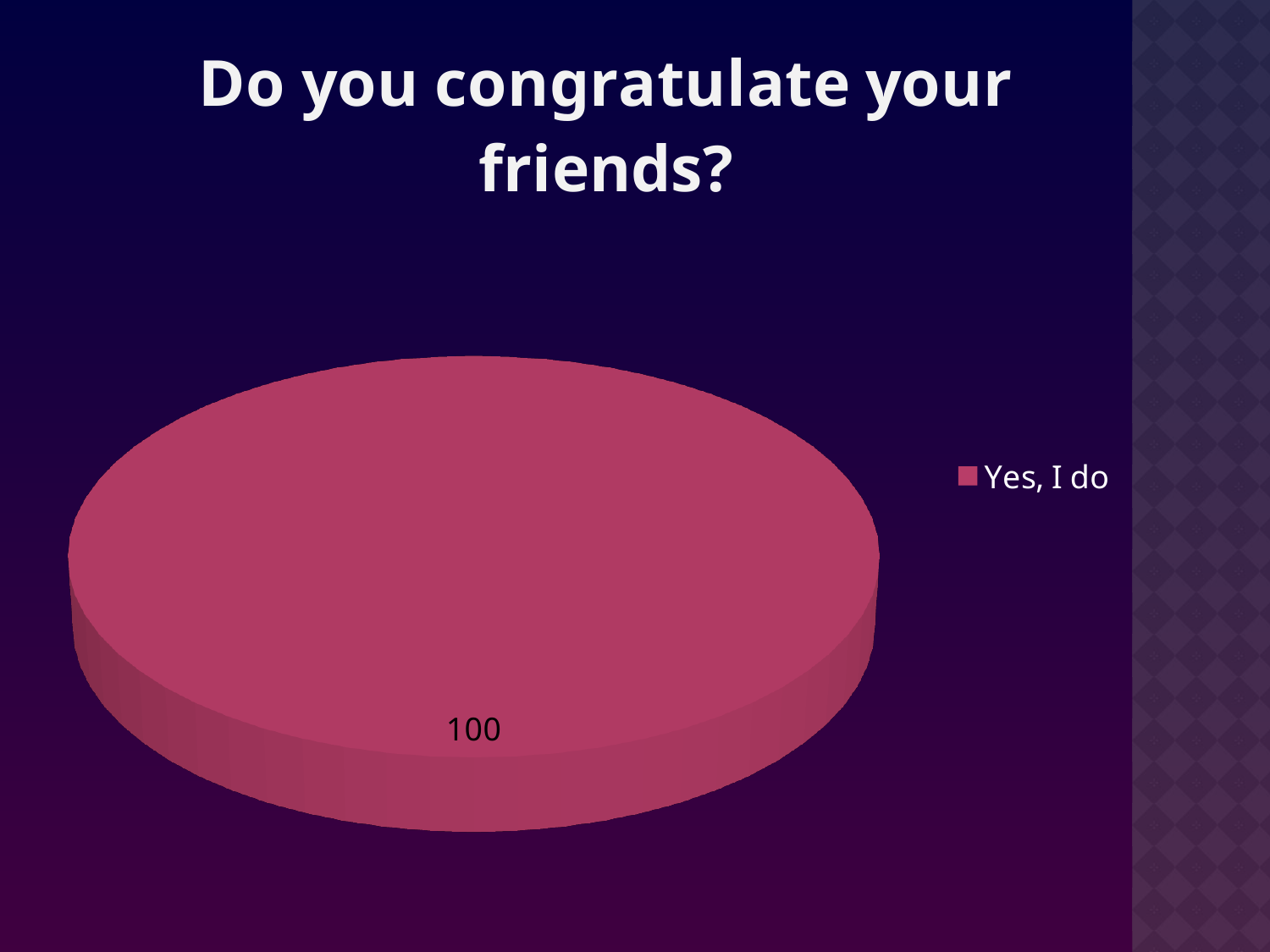
What is the title of the slide above the chart? Do you congratulate your friends? What is the value shown for "Yes, I do"? 100 Is the value for "Yes, I do" greater or less than 50? greater What is the legend entry for the pie chart? Yes, I do How many entries does the legend list? 1 What kind of chart is shown on the slide? pie chart How many slices does the pie chart have? 1 Which category has the highest value in the pie chart? Yes, I do